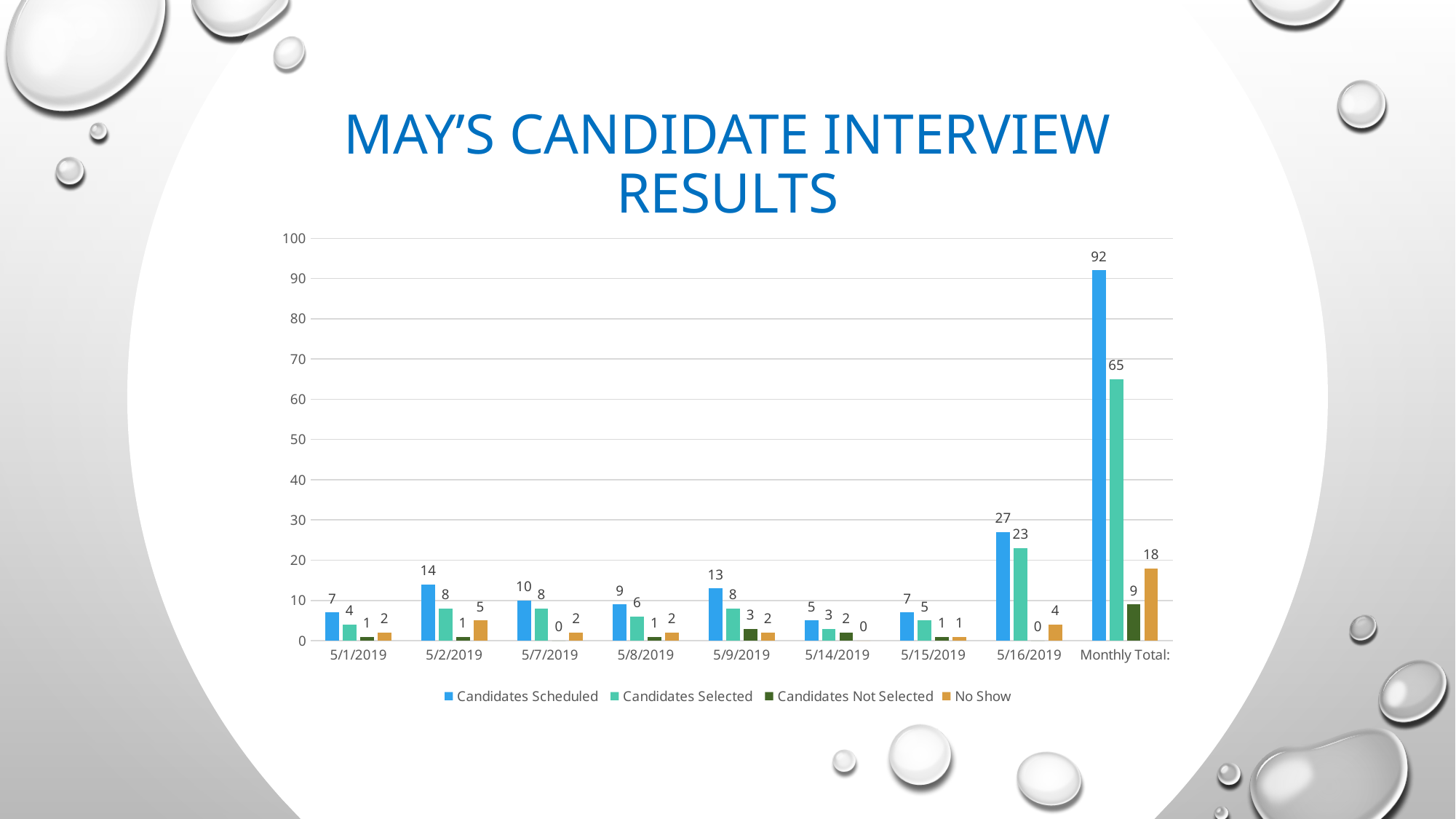
What is the title of the chart? May's Candidate Interview Results Which is larger for 5/2/2019: Candidates Scheduled or Candidates Selected? Candidates Scheduled Excluding the Monthly Total, which date has the highest value for Candidates Scheduled? 5/16/2019 What is the value of Candidates Selected for the Monthly Total? 65 Excluding the Monthly Total, which date has the lowest value for Candidates Scheduled? 5/14/2019 What is the difference between Candidates Scheduled and Candidates Selected for the Monthly Total? 27 How many categories are shown on the x axis? 9 How many series does the legend list? 4 What type of chart is shown on the slide? Bar chart What is the value of No Show for 5/2/2019? 5 What is the value of Candidates Scheduled for 5/16/2019? 27 What is the value of Candidates Not Selected for 5/9/2019? 3